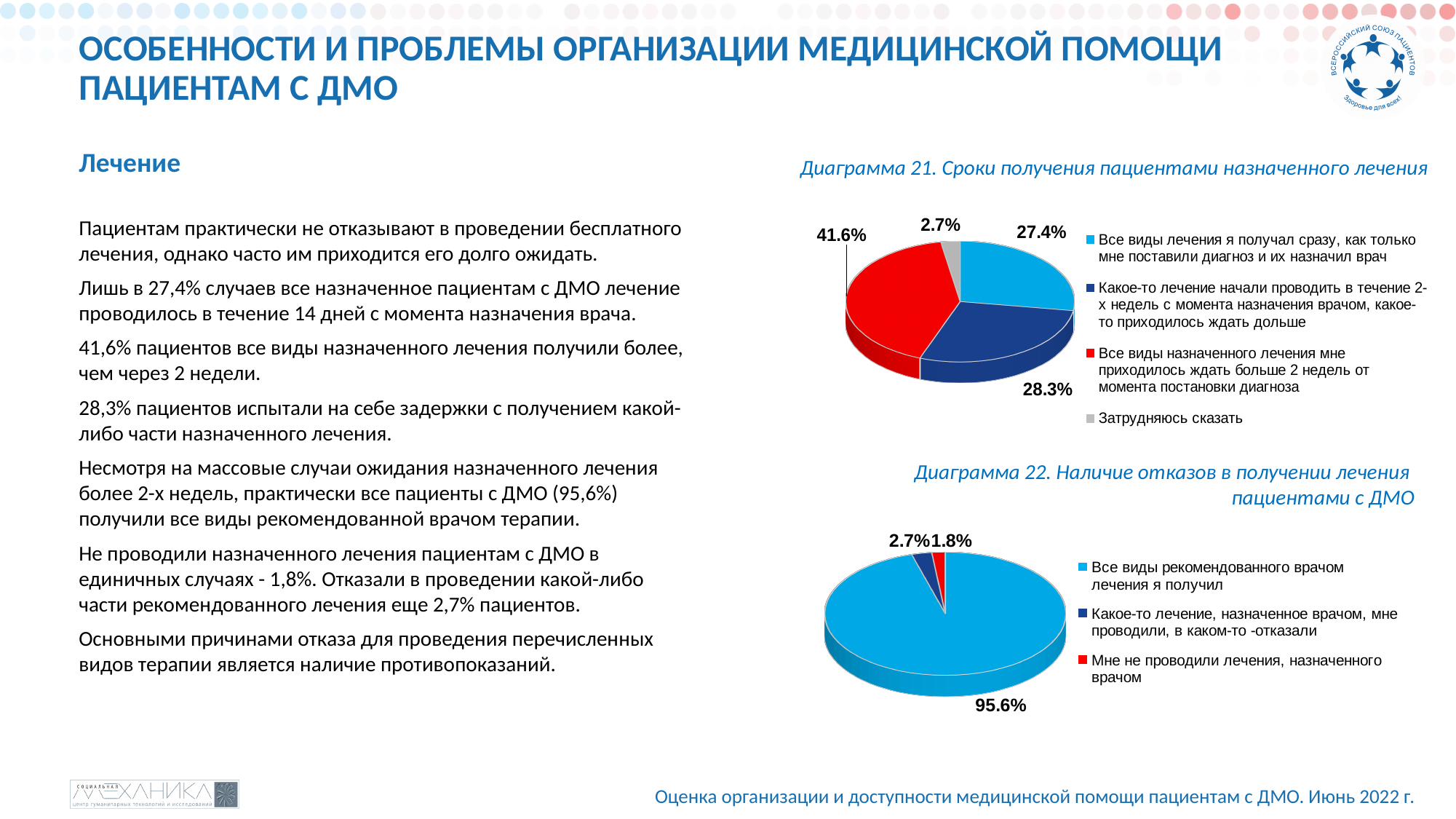
На диаграмме 21 «Сроки получения пациентами назначенного лечения» какая доля пациентов ответила «Затрудняюсь сказать»? 2.7% На диаграмме 21 на сколько процентных пунктов доля ожидавших больше 2 недель (41.6%) превышает долю получивших все лечение сразу (27.4%)? 14.2 На диаграмме 21 сколько категорий (секторов) показано? 4 На диаграмме 21 какой вариант ответа имеет наибольшую долю? Все виды назначенного лечения мне приходилось ждать больше 2 недель от момента постановки диагноза Какого типа диаграмма 21? Круговая диаграмма На диаграмме 21 какой вариант ответа имеет наименьшую долю? Затрудняюсь сказать На диаграмме 21 какая доля пациентов получила все виды лечения сразу, как только поставили диагноз и их назначил врач? 27.4% Сколько категорий перечислено в легенде диаграммы 22? 3 На диаграмме 22 «Наличие отказов в получении лечения пациентами с ДМО» какая доля пациентов получила все виды рекомендованного врачом лечения? 95.6% На диаграмме 22 что больше: доля «Какое-то лечение, назначенное врачом, мне проводили, в каком-то - отказали» или доля «Мне не проводили лечения, назначенного врачом»? Какое-то лечение, назначенное врачом, мне проводили, в каком-то - отказали На диаграмме 21 какая доля пациентов ждала все виды назначенного лечения больше 2 недель с момента постановки диагноза? 41.6% На диаграмме 22 какая доля пациентов ответила, что им не проводили лечения, назначенного врачом? 1.8%